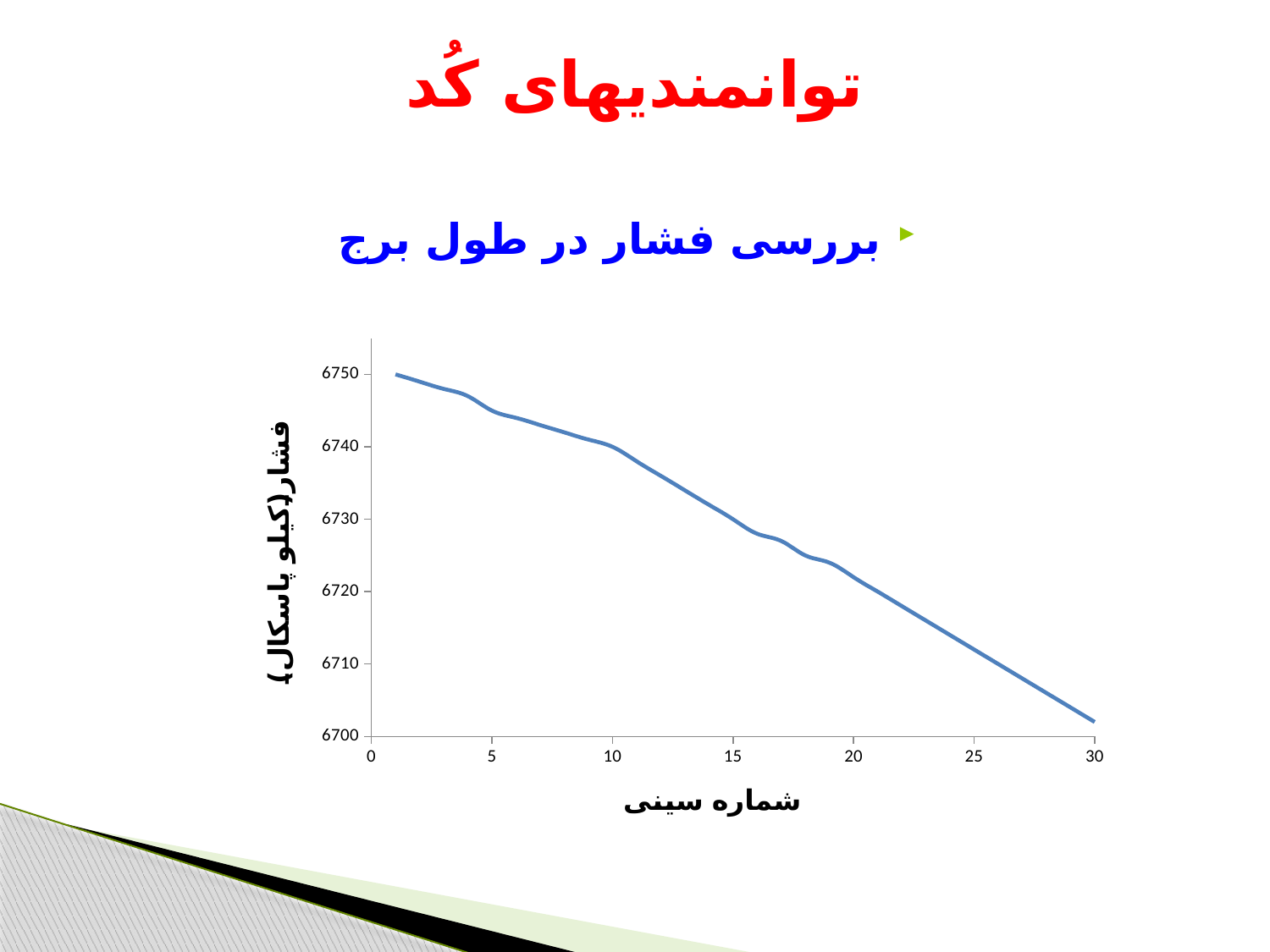
What colour is the line in the chart? blue Which has the higher pressure, tray 5 or tray 25? tray 5 What kind of chart is shown on the slide? line chart What is the label on the x axis of the chart? شماره سینی Does the pressure rise or fall as the tray number increases along the x axis? fall Which tray number has the lowest pressure? 30 Is the pressure at tray 20 greater or less than 6730? less Which tray number has the highest pressure? 1 Is the pressure at tray 5 greater or less than 6740? greater Is the pressure at tray 30 greater or less than 6710? less